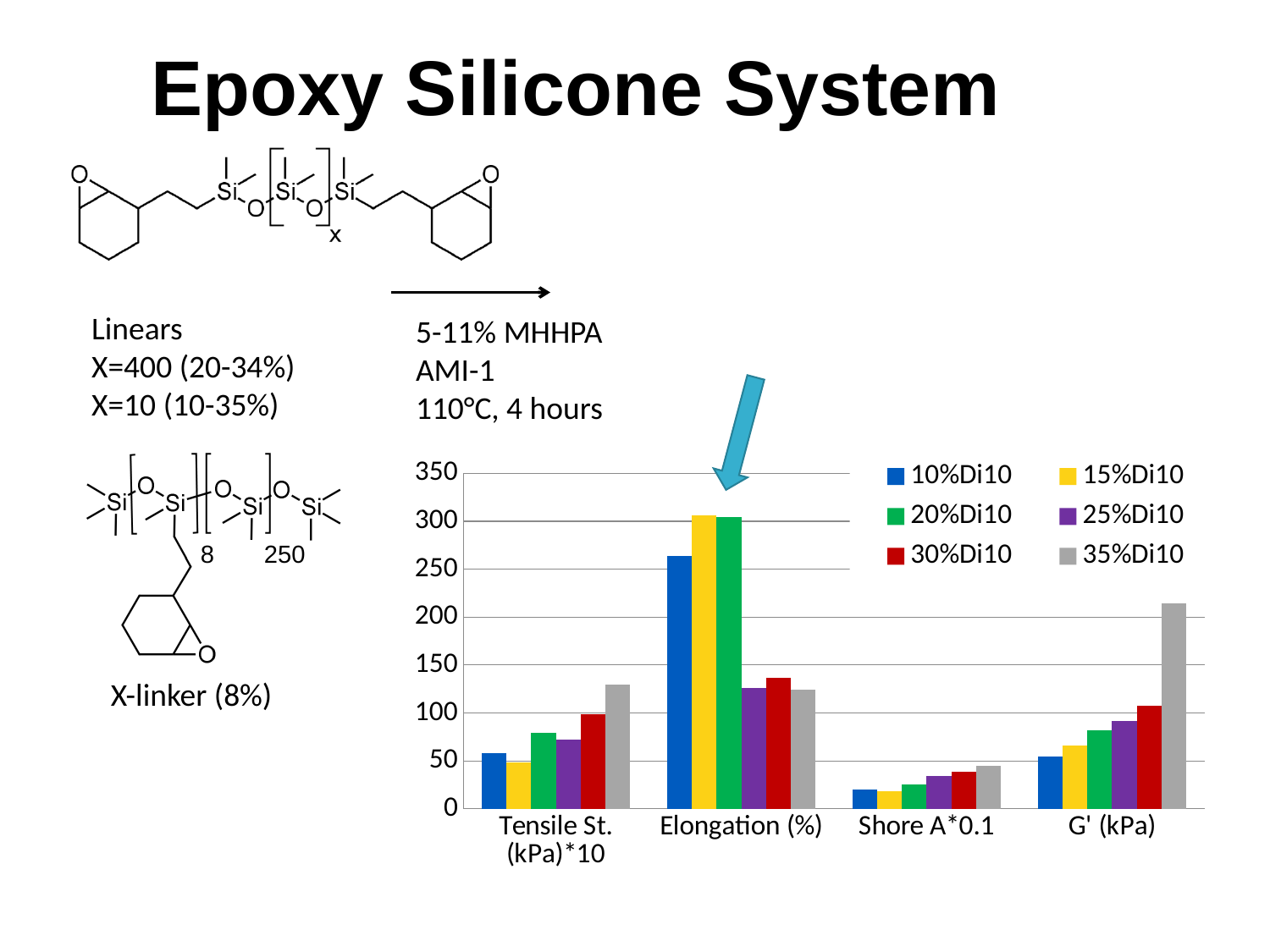
Is the value for 10%Di10 in the Elongation (%) category greater or less than 250? greater Which colour represents the 30%Di10 series in the chart legend? red Which series has the highest value in the Shore A*0.1 category? 35%Di10 Is the value for 35%Di10 in the G' (kPa) category greater or less than 200? greater Is the value for 35%Di10 in the Tensile St. (kPa)*10 category greater or less than 100? greater Which series has the lowest value in the Tensile St. (kPa)*10 category? 15%Di10 How many categories are shown on the x axis of the chart? 4 Which series has the highest value in the G' (kPa) category? 35%Di10 In the Elongation (%) category, which is larger: the value for 10%Di10 or the value for 25%Di10? 10%Di10 How many series does the chart legend list? 6 What kind of chart is shown on the slide? bar chart